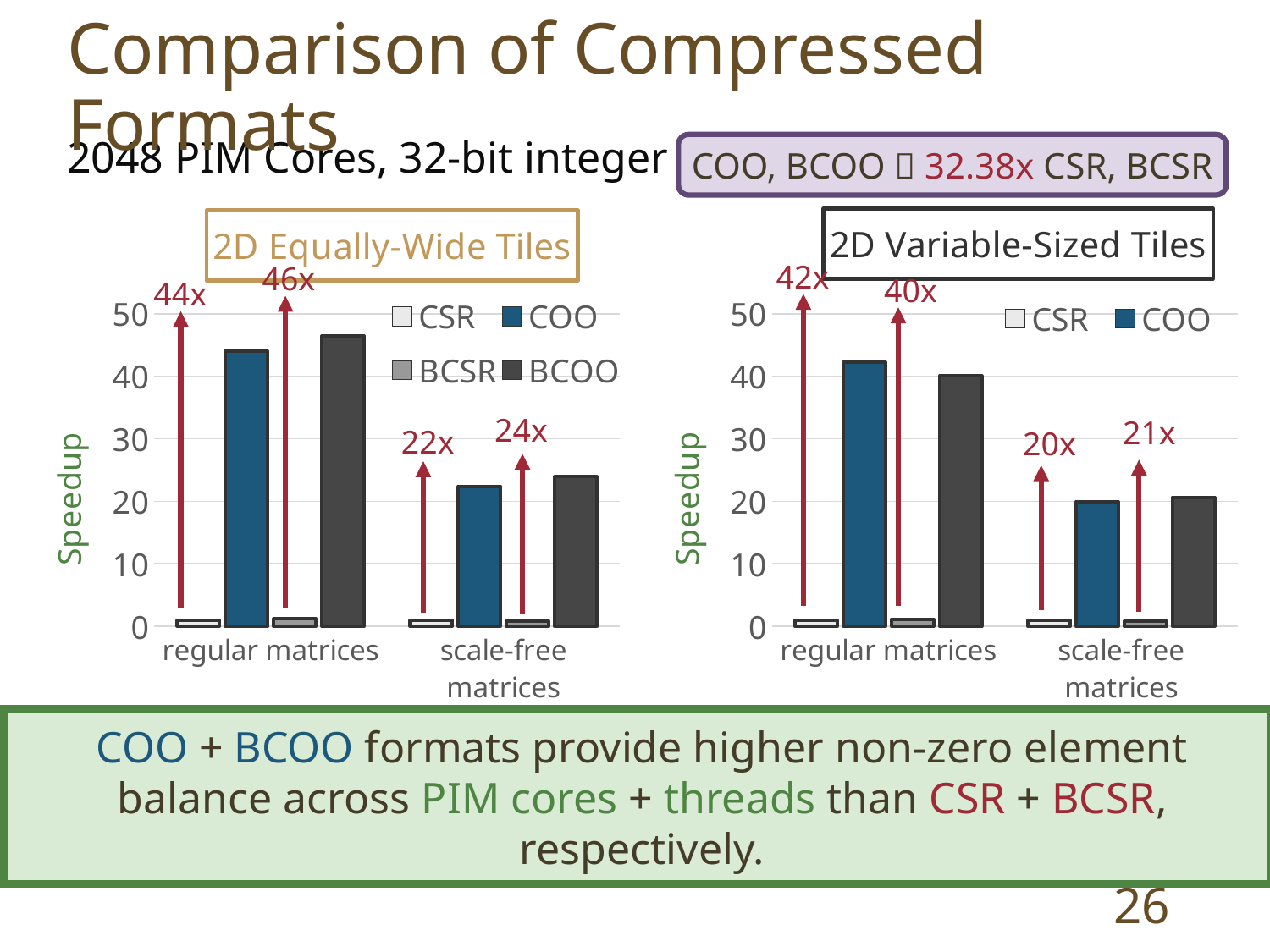
How many series does the legend of the 2D Equally-Wide Tiles chart list? 4 In the 2D Equally-Wide Tiles chart, what annotation is printed above the second arrow for regular matrices? 46x In the 2D Variable-Sized Tiles chart, is the COO value for regular matrices greater or less than 40? greater In the 2D Variable-Sized Tiles chart, is the COO value for scale-free matrices greater or less than 30? less In the 2D Equally-Wide Tiles chart, which category has the larger COO value, regular matrices or scale-free matrices? regular matrices In the 2D Equally-Wide Tiles chart, is the COO value for regular matrices greater or less than 40? greater In the 2D Variable-Sized Tiles chart, which category has the larger BCOO value, regular matrices or scale-free matrices? regular matrices What is the y-axis label of the 2D Variable-Sized Tiles chart? Speedup What kind of chart is the 2D Equally-Wide Tiles chart? bar chart In the 2D Variable-Sized Tiles chart, do the BCOO values rise or fall from regular matrices to scale-free matrices? fall How many categories are shown on the x axis of the 2D Variable-Sized Tiles chart? 2